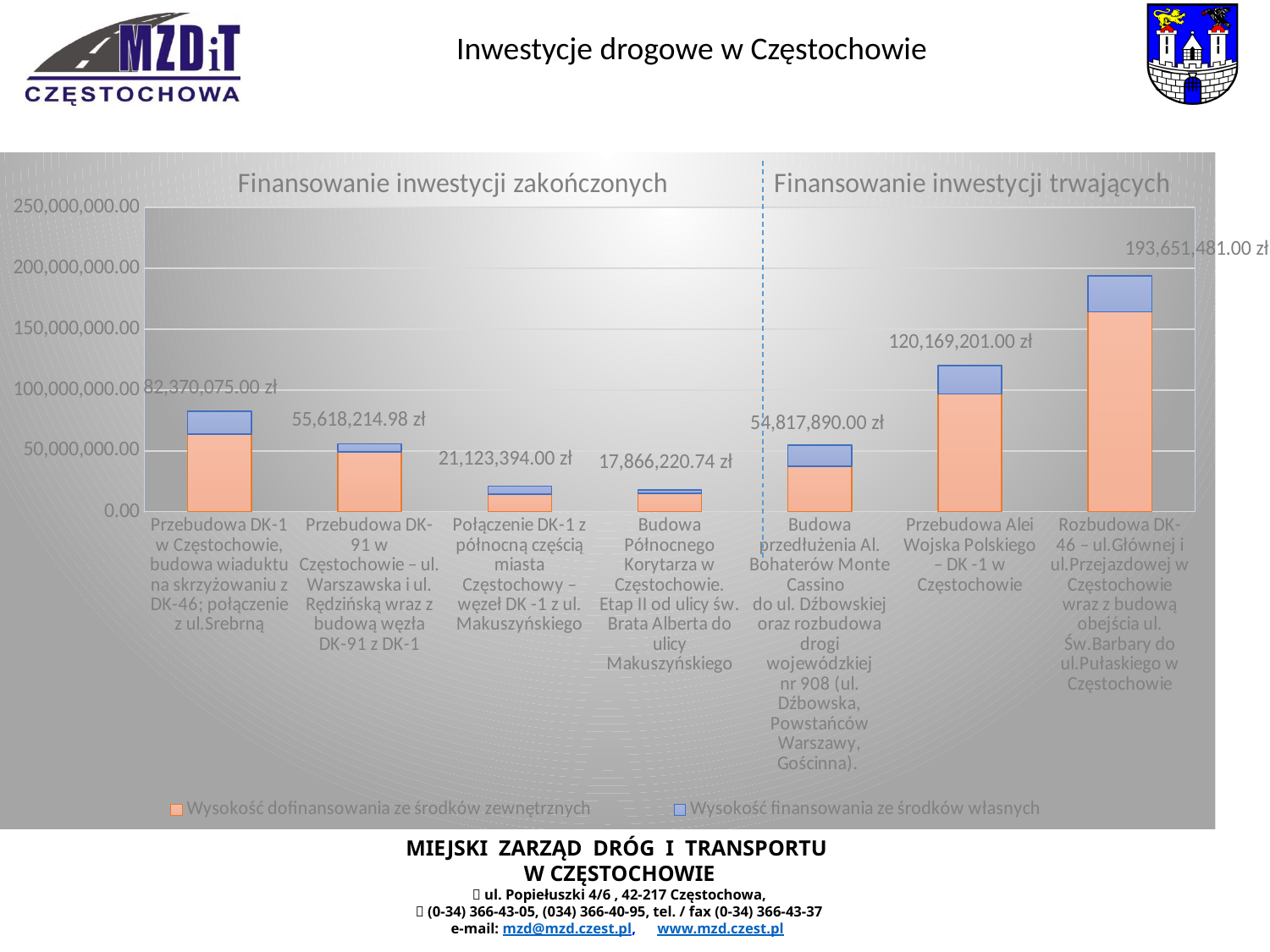
How many series does the chart legend list? 2 How many investments (bars) are shown on the chart? 7 What is the difference between the labelled values for 'Rozbudowa DK-46' and 'Przebudowa Alei Wojska Polskiego'? 73,482,280.00 zł Which investment has the highest labelled value on the chart? Rozbudowa DK-46 – ul.Głównej i ul.Przejazdowej w Częstochowie What kind of chart is shown on the slide? Stacked bar chart Which investment has the lowest labelled value on the chart? Budowa Północnego Korytarza w Częstochowie What is the value labelled for 'Przebudowa DK-91 w Częstochowie'? 55,618,214.98 zł What is the value labelled for 'Przebudowa Alei Wojska Polskiego – DK -1 w Częstochowie'? 120,169,201.00 zł What is the total value labelled for the bar 'Rozbudowa DK-46 – ul.Głównej i ul.Przejazdowej w Częstochowie'? 193,651,481.00 zł Is the total value for 'Przebudowa Alei Wojska Polskiego – DK -1 w Częstochowie' greater or less than 100,000,000.00? greater What is the value labelled for 'Budowa Północnego Korytarza w Częstochowie'? 17,866,220.74 zł Which has a larger labelled value: 'Przebudowa DK-1 w Częstochowie' or 'Budowa przedłużenia Al. Bohaterów Monte Cassino'? Przebudowa DK-1 w Częstochowie